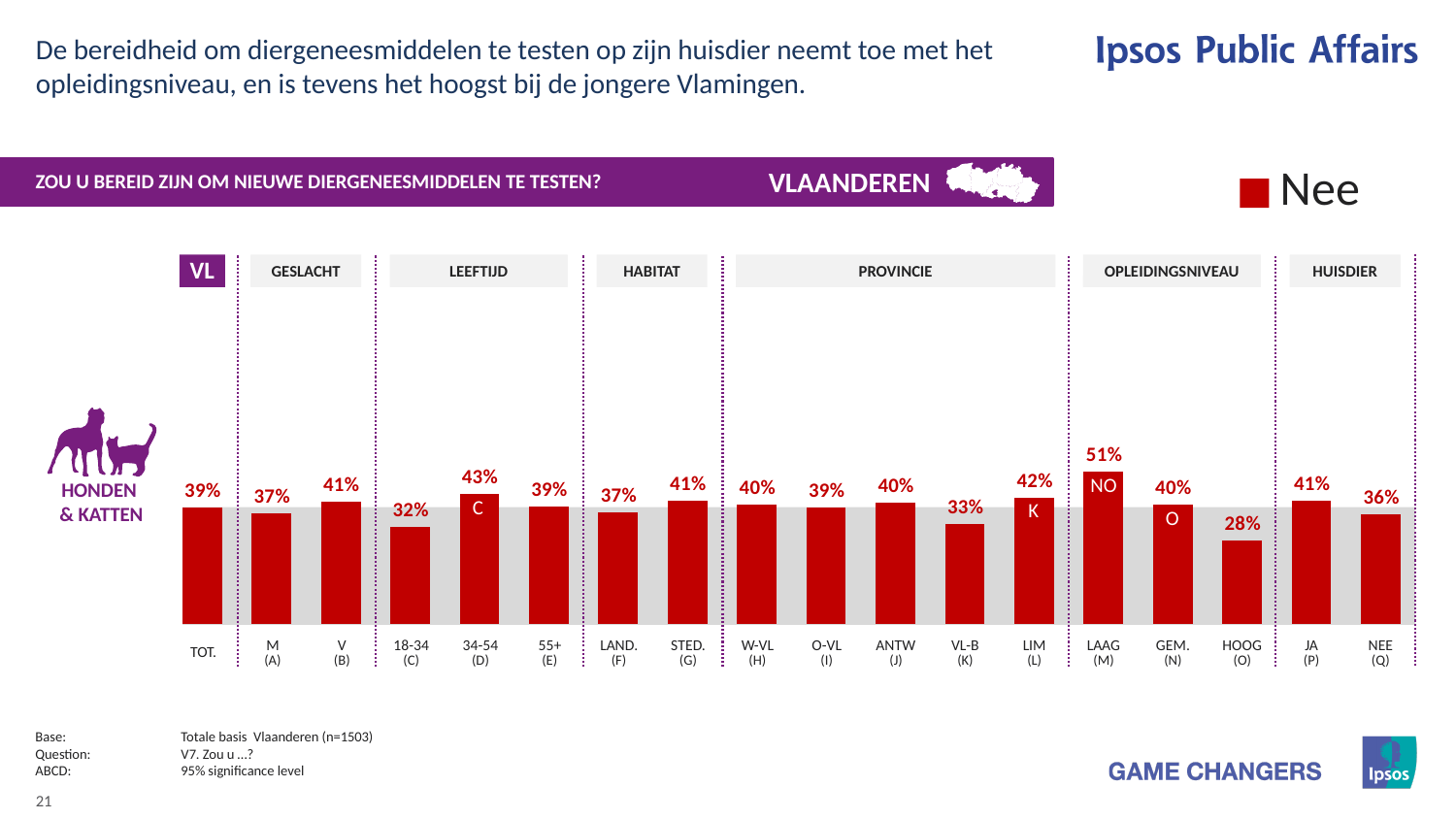
How many series does the legend list? 1 What is the value for the 18-34 (C) age group? 32% Which category has the highest value in the chart? LAAG (M) Which category has the lowest value in the chart? HOOG (O) Which is larger, the value for M (A) or the value for V (B)? V (B) What is the value for the LAAG (M) education level? 51% What kind of chart is shown on the slide? Bar chart What is the value for VL-B (K) in the Provincie section? 33% What is the difference between the values for 34-54 (D) and 18-34 (C)? 11% What is the difference between the values for LAAG (M) and HOOG (O)? 23% What is the value for TOT. (total) in the chart? 39% How many bars are plotted in the chart? 18